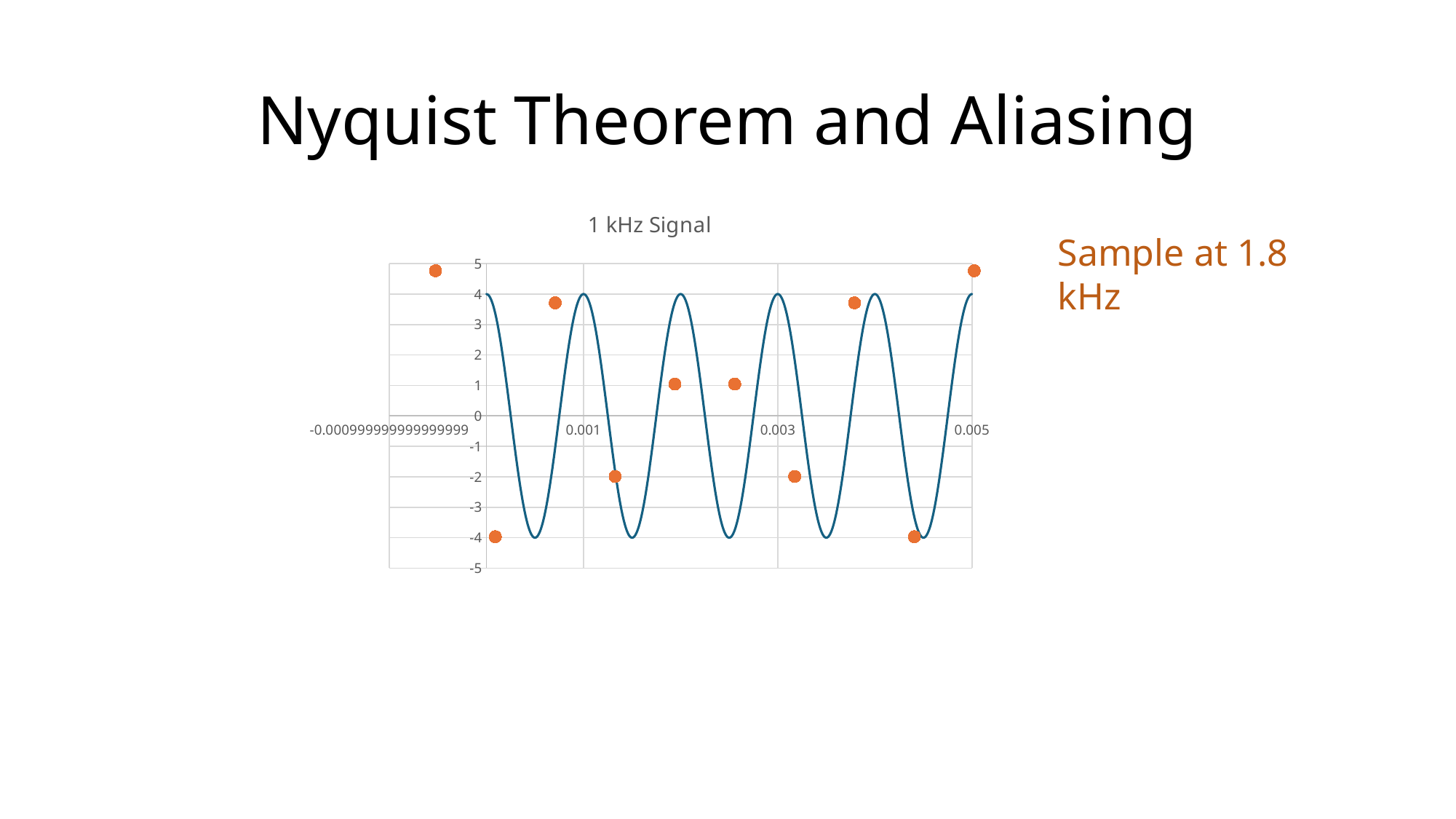
Is the highest orange sample point on the chart greater or less than 4? greater How many orange sample points on the chart lie above 0? 6 What kind of chart is shown on the slide? line chart What is the rightmost label on the horizontal axis of the chart? 0.005 Is the lowest orange sample point on the chart greater or less than -3? less What is the highest value shown on the vertical axis of the chart? 5 Which is larger: the peak of the blue curve or the highest orange sample point? the highest orange sample point How many orange sample points on the chart lie below 0? 4 What is the maximum value the blue curve reaches on the chart? 4 What is the minimum value the blue curve reaches on the chart? -4 How many orange sample points are plotted on the chart? 10 What is the title of the chart? 1 kHz Signal